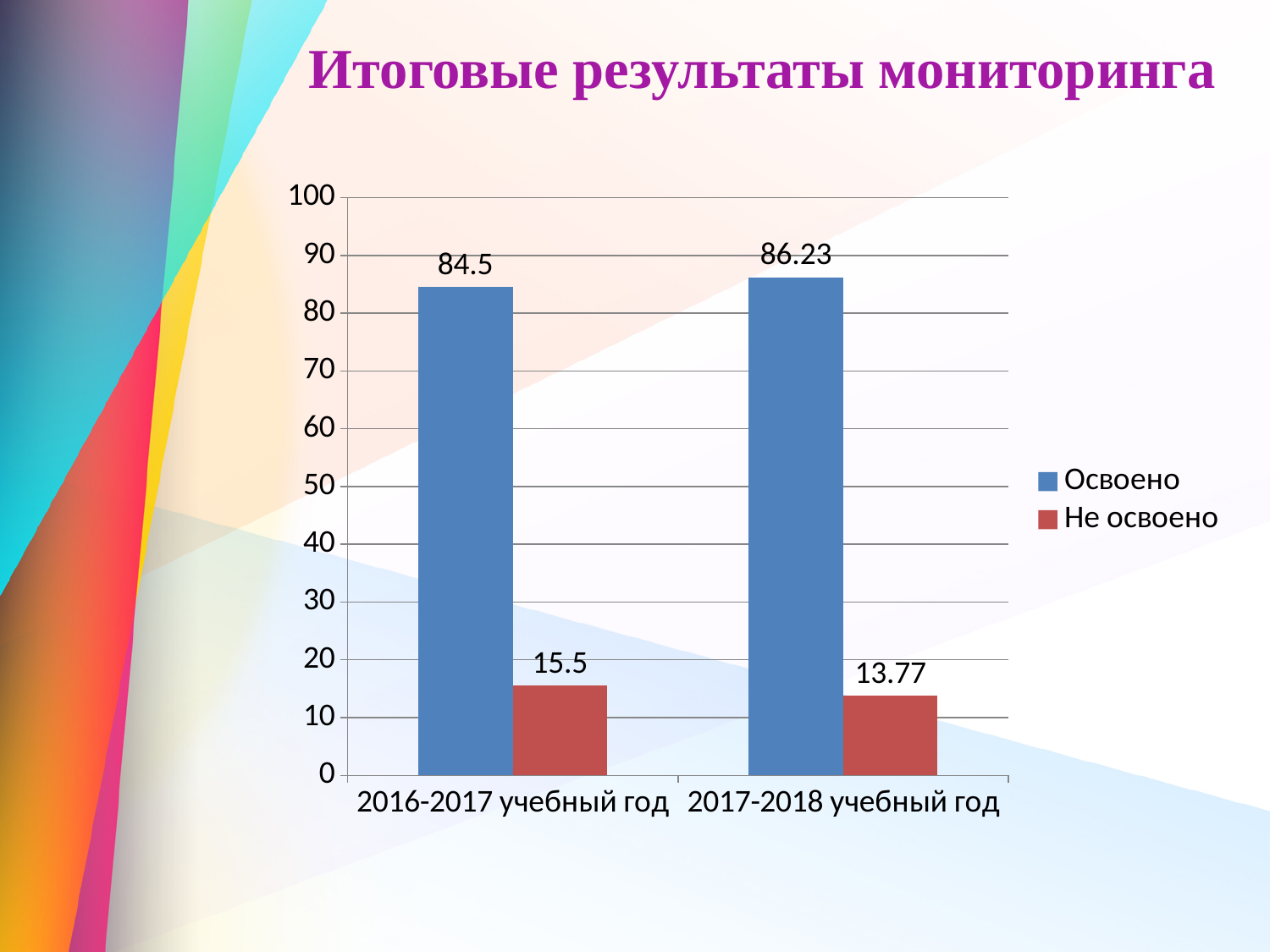
Which year has the higher Освоено value? 2017-2018 учебный год What is the value of Освоено for 2017-2018 учебный год? 86.23 What kind of chart is shown on the slide? bar chart What is the difference between the Освоено values for 2017-2018 and 2016-2017? 1.73 How many series does the legend list? 2 What is the value of Освоено for 2016-2017 учебный год? 84.5 Does the Освоено value rise or fall from 2016-2017 to 2017-2018? rise What is the value of Не освоено for 2017-2018 учебный год? 13.77 Is the Не освоено value for 2016-2017 учебный год larger or smaller than for 2017-2018 учебный год? larger What is the value of Не освоено for 2016-2017 учебный год? 15.5 Which year has the lower Не освоено value? 2017-2018 учебный год How many categories are shown on the x axis? 2